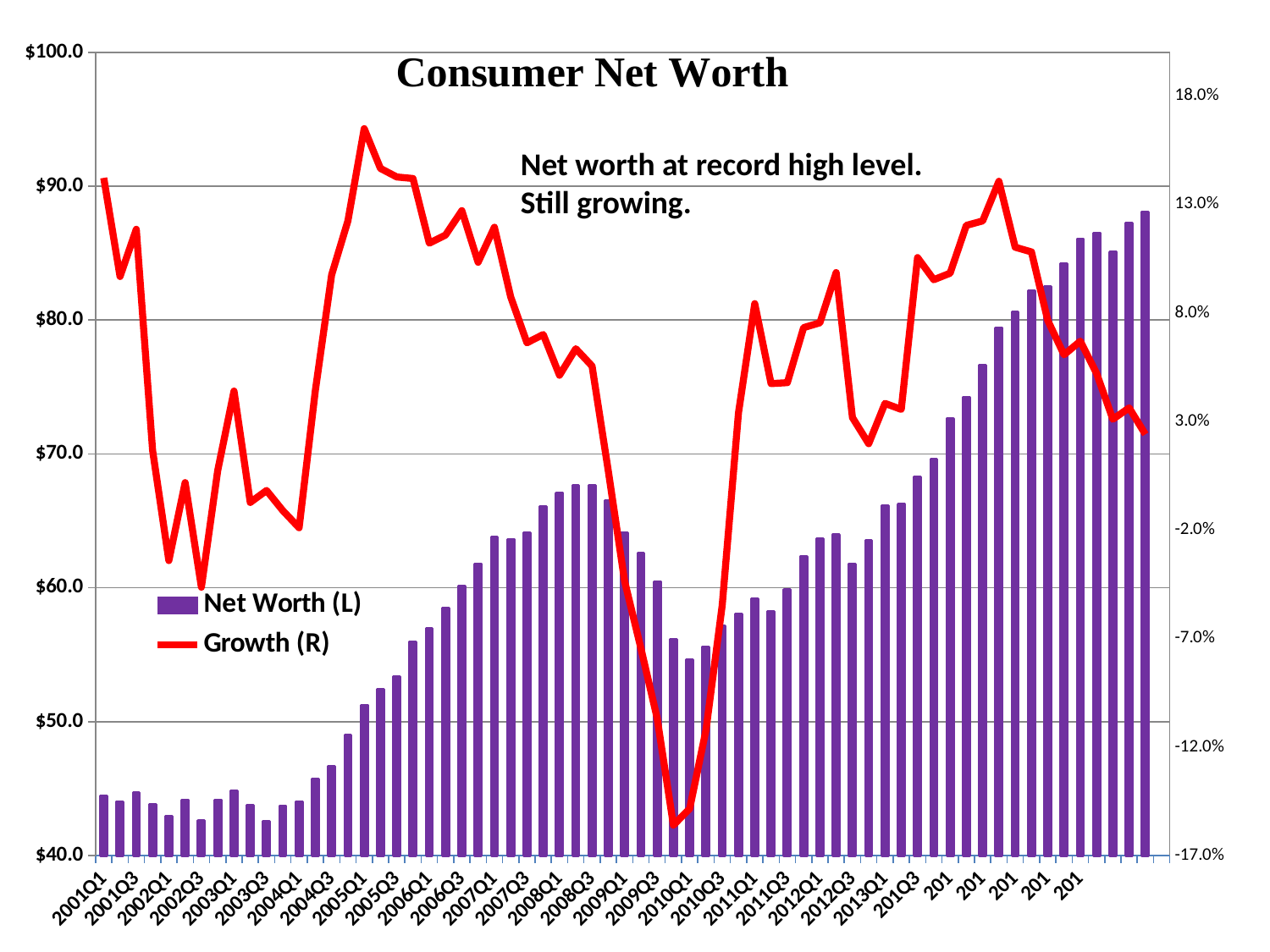
Is the Net Worth value for 2006Q1 greater or less than $50.0? greater Is the Growth value for 2010Q1 greater or less than -12.0%? less What is the title of the chart? Consumer Net Worth How many series does the legend list? 2 In which quarter is the Growth series at its lowest? 2009Q4 What kind of chart is this? Combined bar and line chart Is the Net Worth value for 2013Q1 greater or less than $60.0? greater Which series is plotted as a red line? Growth (R) Does Net Worth rise or fall from 2009Q1 to 2013Q3? rise